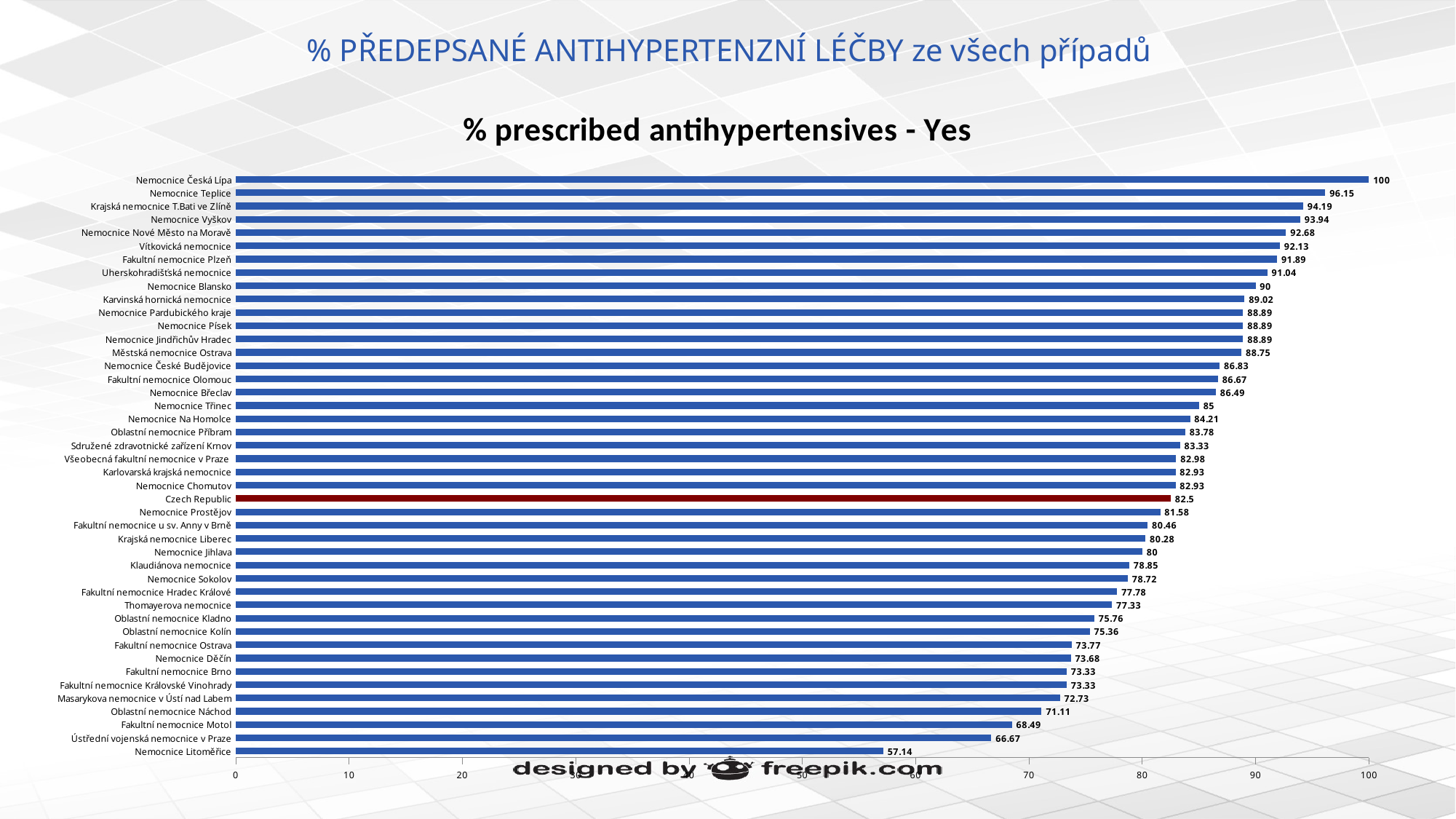
What kind of chart is shown on the slide? bar chart Which category has the lowest value? Nemocnice Litoměřice What is the value for Nemocnice Česká Lípa? 100 What is the value for Fakultní nemocnice Motol? 68.49 Which category's bar is coloured red instead of blue? Czech Republic What is the value for Nemocnice Blansko? 90 Which category has the highest value? Nemocnice Česká Lípa What is the difference between the values for Nemocnice Teplice and Nemocnice Litoměřice? 39.01 Is the value for Ústřední vojenská nemocnice v Praze greater or less than 70? less What is the value for Czech Republic? 82.5 Which is larger, the value for Nemocnice Jihlava or the value for Oblastní nemocnice Kladno? Nemocnice Jihlava What is the title of the chart? % prescribed antihypertensives - Yes